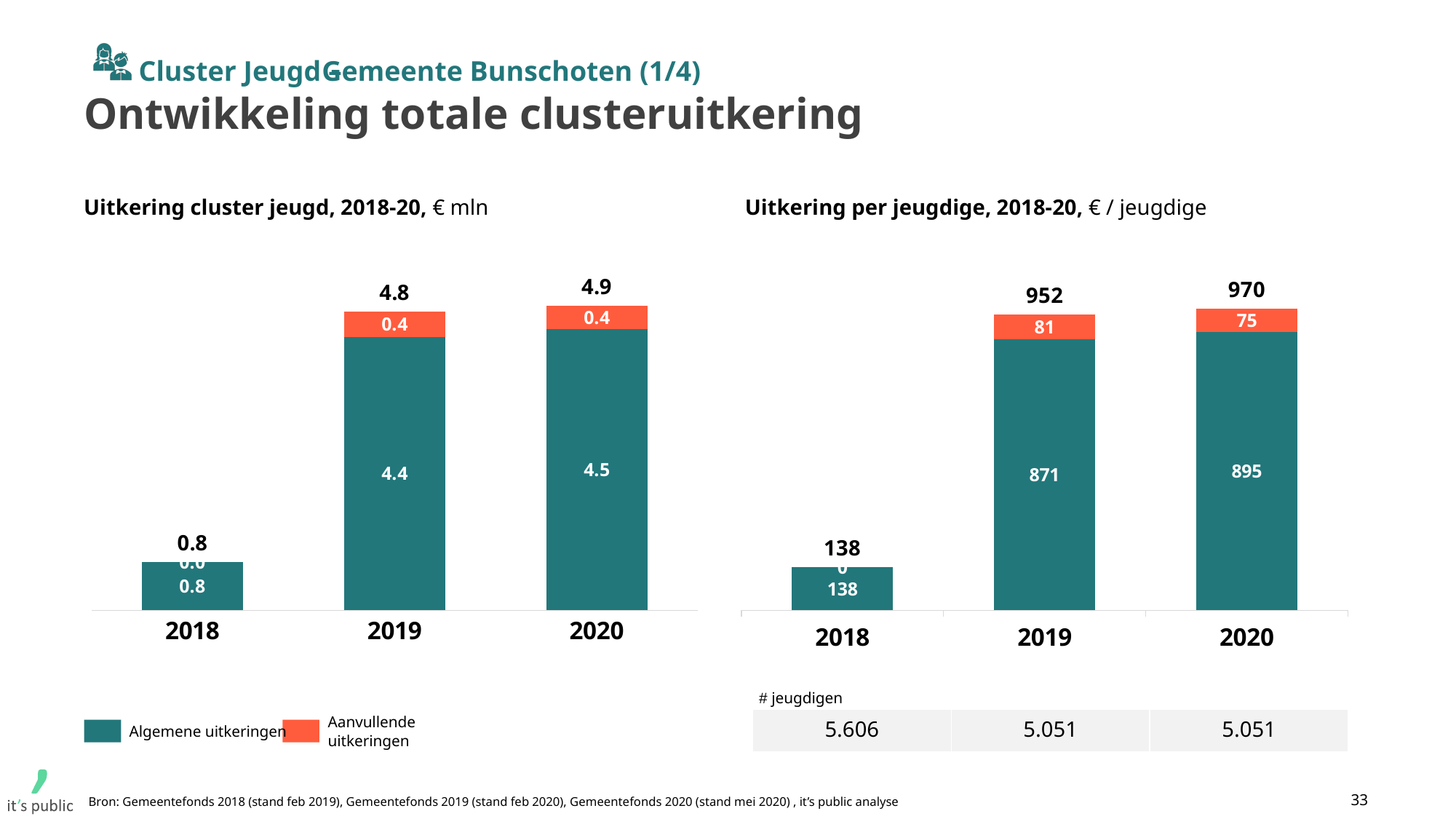
How many series does the legend list for the charts on this slide? 2 In the 'Uitkering per jeugdige, 2018-20' chart, what is the difference between the Algemene uitkeringen values for 2020 and 2019? 24 In the 'Uitkering cluster jeugd, 2018-20' chart, what is the value of Algemene uitkeringen for 2019? 4.4 In the 'Uitkering cluster jeugd, 2018-20' chart, which year has the lowest total? 2018 What kind of chart is the 'Uitkering per jeugdige, 2018-20' chart? Stacked bar chart In the 'Uitkering per jeugdige, 2018-20' chart, what is the value of Aanvullende uitkeringen for 2019? 81 In the 'Uitkering per jeugdige, 2018-20' chart, which year has the highest total? 2020 In the 'Uitkering per jeugdige, 2018-20' chart, is the Aanvullende uitkeringen value larger for 2019 or 2020? 2019 In the 'Uitkering cluster jeugd, 2018-20' chart, what is the difference between the Algemene uitkeringen values for 2020 and 2019? 0.1 How many years are shown on the x axis of the 'Uitkering cluster jeugd, 2018-20' chart? 3 In the 'Uitkering per jeugdige, 2018-20' chart, what is the total of the stacked bar for 2020? 970 In the 'Uitkering cluster jeugd, 2018-20' chart, what is the total of the stacked bar for 2020? 4.9